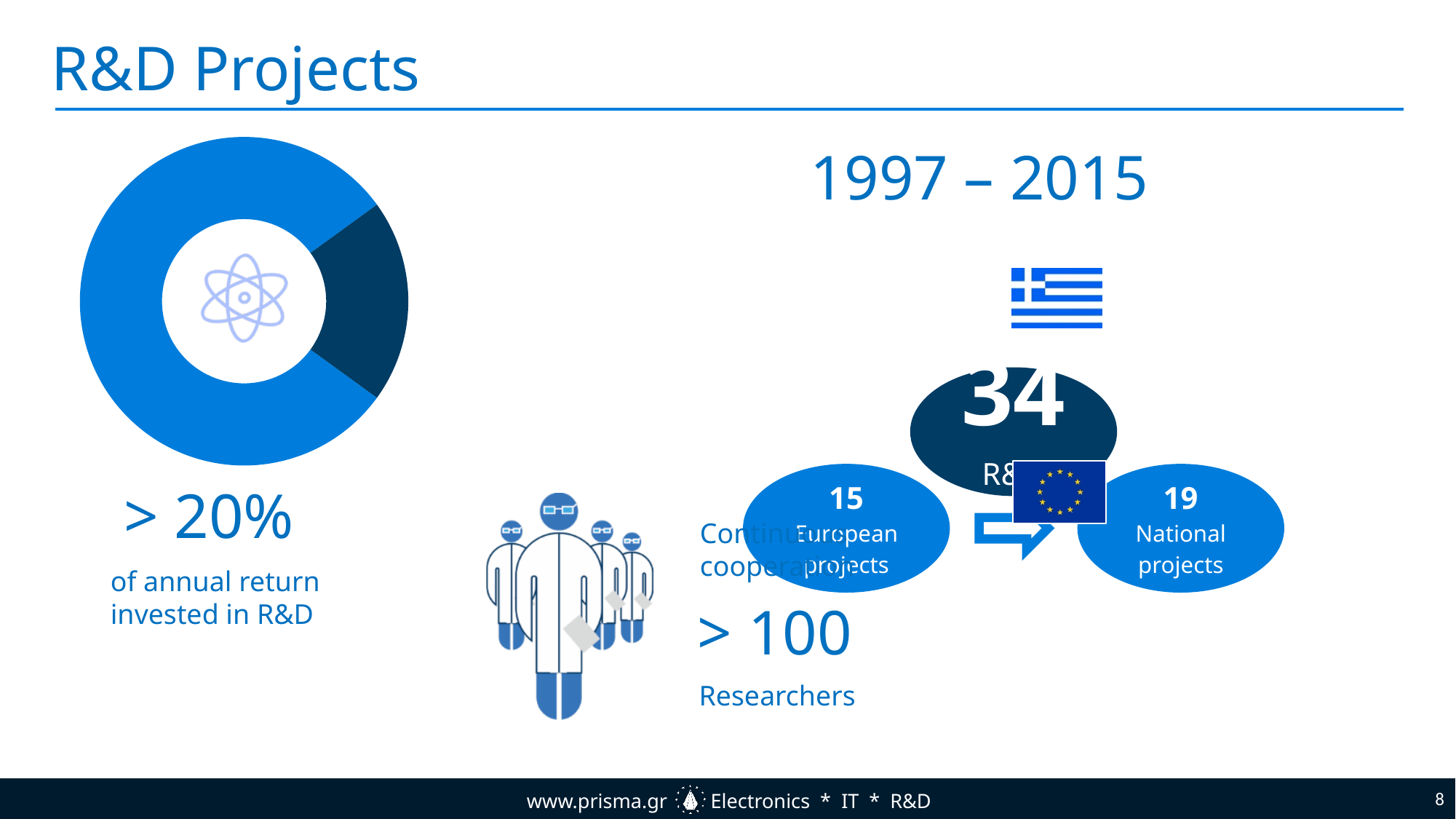
What kind of chart is shown on the left of the slide? Pie (donut) chart Does the dark blue slice of the donut chart cover more or less than half of the ring? Less According to the caption under the donut chart, what does the highlighted share represent? Annual return invested in R&D What percentage figure is printed below the donut chart? > 20% How many slices does the donut chart on the left have? 2 What icon is shown in the centre of the donut chart? An atom In the donut chart, which slice is larger, the light blue one or the dark blue one? The light blue one